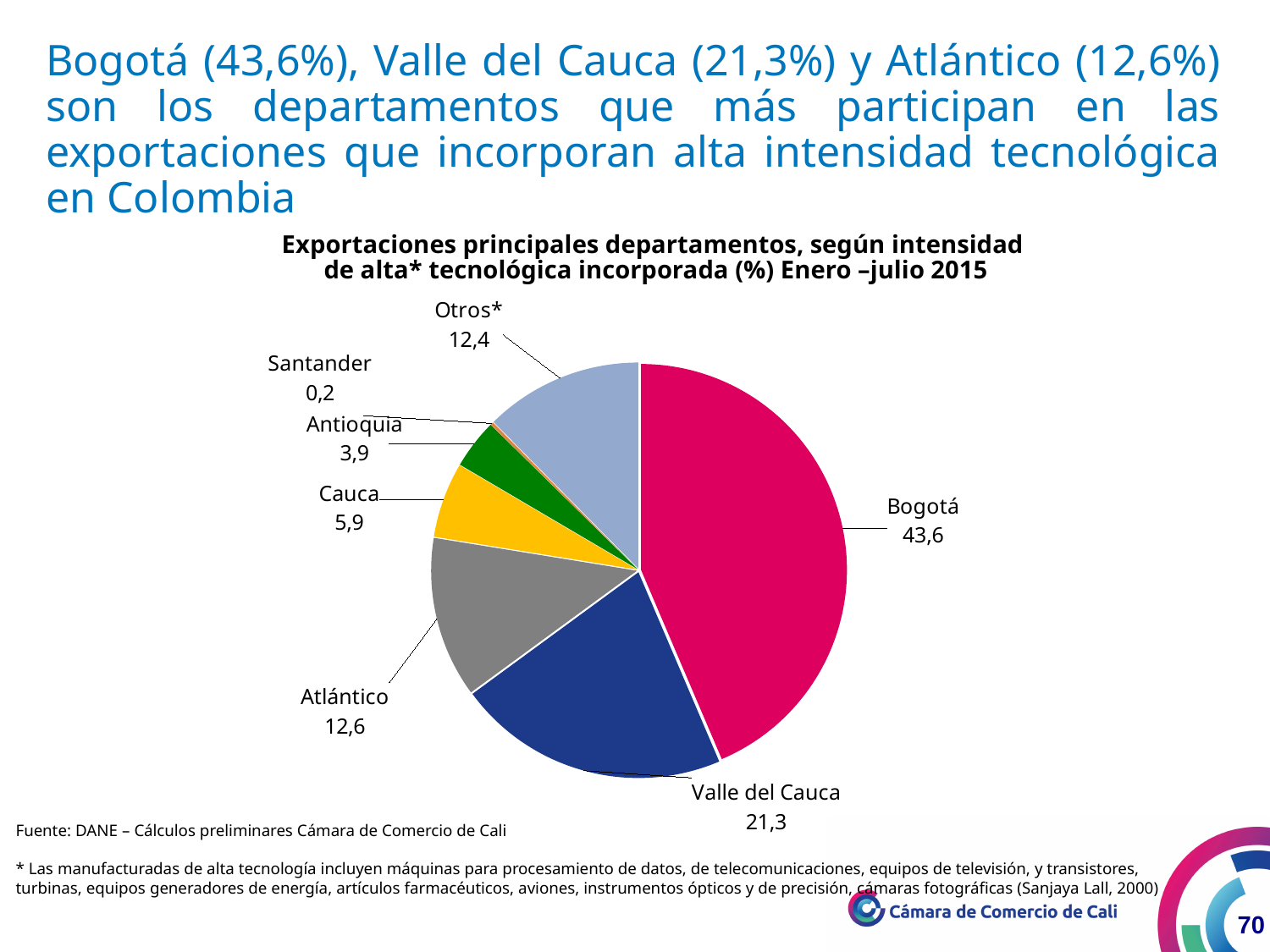
What period does the chart title say the data covers? Enero –julio 2015 What is the value shown for Valle del Cauca? 21,3 What type of chart is shown on the slide? Pie chart What is the value shown for Cauca? 5,9 What is the difference between the values for Bogotá and Valle del Cauca? 22,3 What is the value shown for Bogotá? 43,6 Which department has the largest slice of the pie? Bogotá How many slices does the pie chart have? 7 Which is larger, the value for Antioquia or the value for Cauca? Cauca What is the difference between the values for Cauca and Antioquia? 2,0 Which category has the smallest slice of the pie? Santander What is the value shown for Santander? 0,2